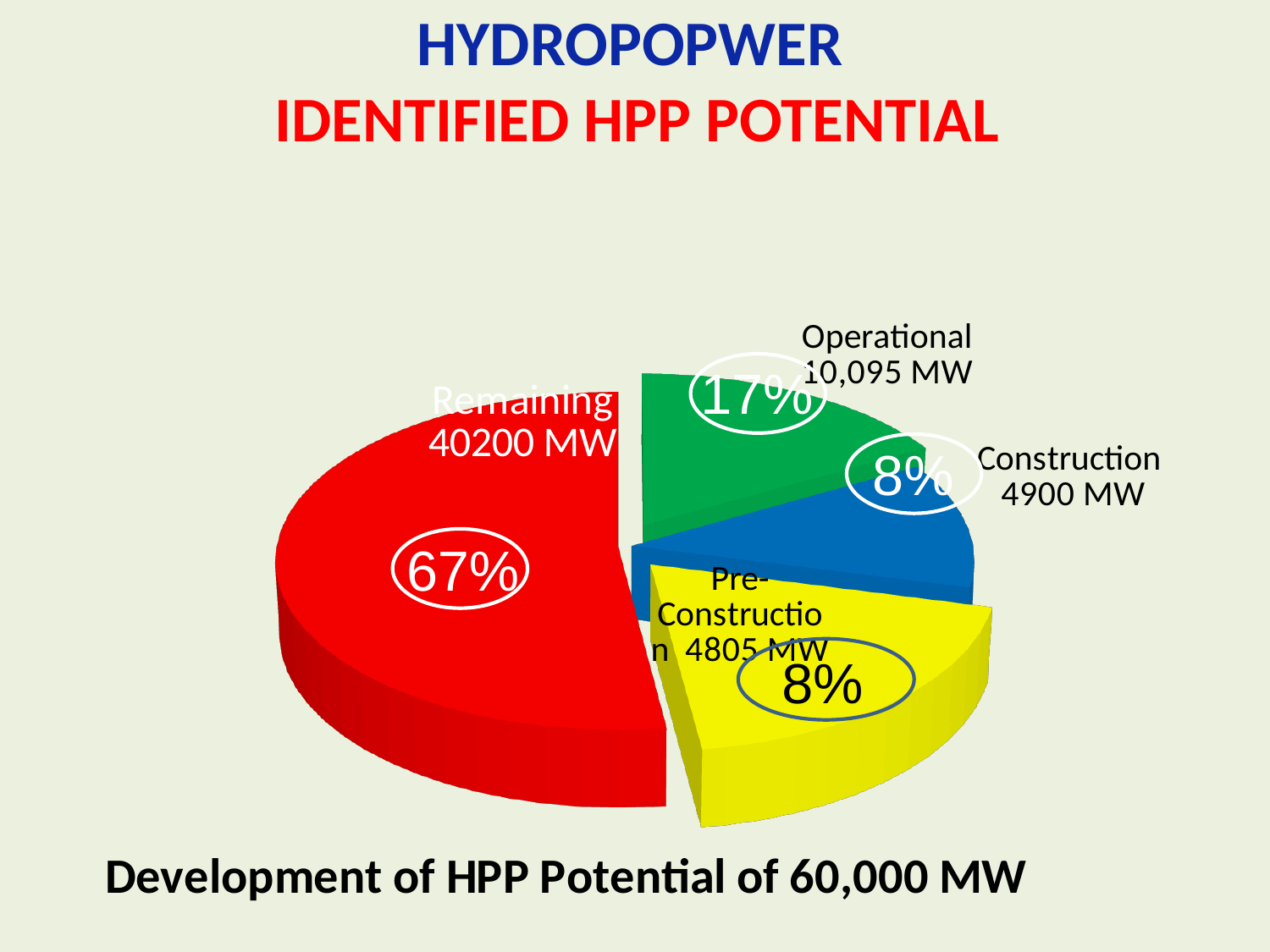
Which is larger, the Construction value or the Pre-Construction value? Construction What is the value for the Remaining slice? 40200 MW What share of the pie does the Operational slice represent? 17% What colour is the Remaining slice? Red What is the value for the Construction slice? 4900 MW What is the difference in MW between the Operational and Construction slices? 5195 MW Which category has the largest slice of the pie? Remaining What is the value for the Pre-Construction slice? 4805 MW What is the value for the Operational slice? 10,095 MW How many slices does the pie chart have? 4 What share of the pie does the Remaining slice represent? 67% What kind of chart is shown on the slide? Pie chart